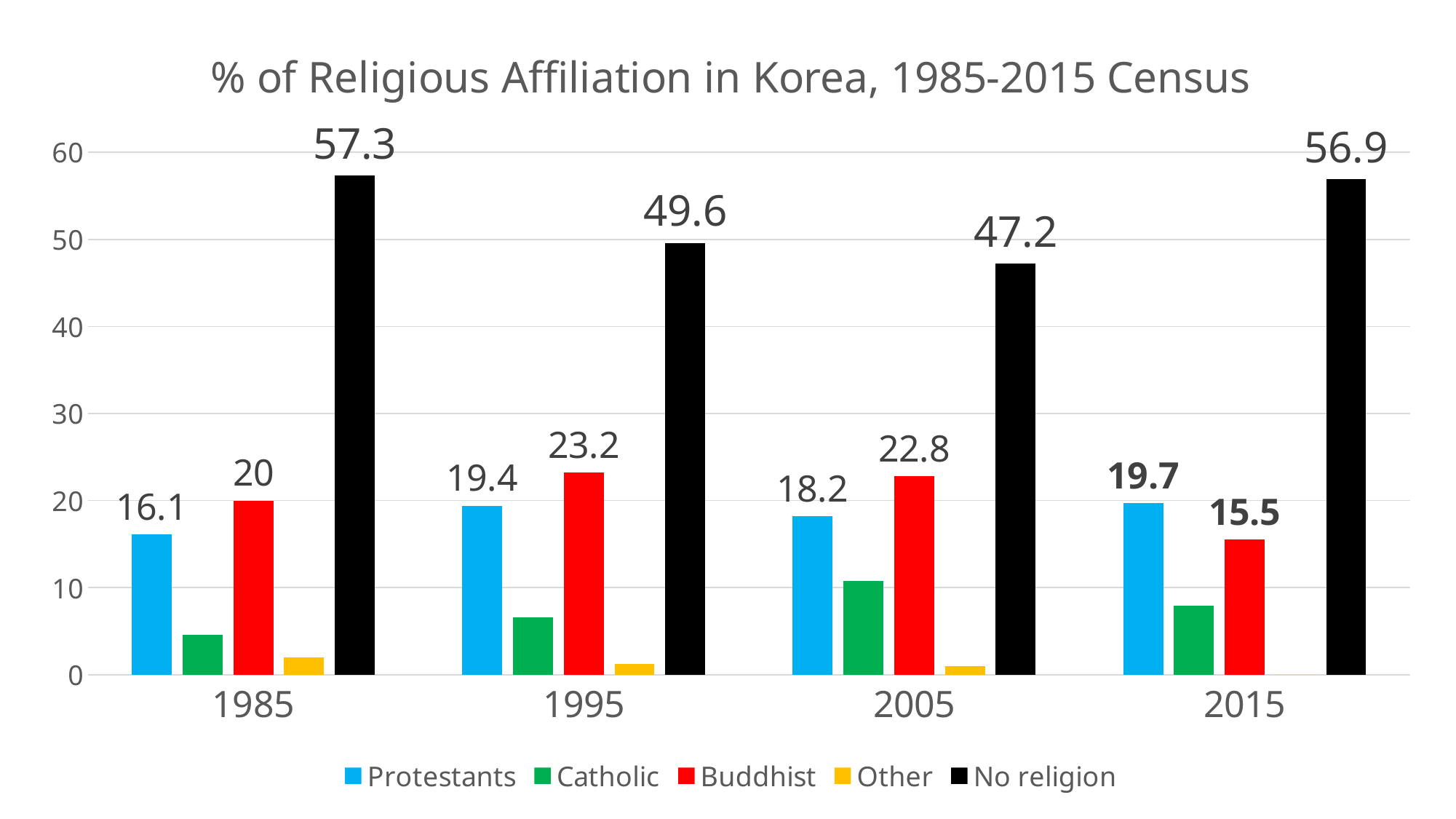
What is the difference between the No religion values in 1985 and 1995? 7.7 Which is larger, the Protestants value in 2015 or the Buddhist value in 2015? Protestants How many years are shown on the x axis? 4 How many series does the legend list? 5 What is the value for Protestants in 2015? 19.7 What is the title of the chart? % of Religious Affiliation in Korea, 1985-2015 Census What is the value for Buddhist in 1995? 23.2 Is the value for Catholic in 2005 greater or less than 20? less In which year is the Buddhist value highest? 1995 What is the value for No religion in 1985? 57.3 In which year is the No religion value lowest? 2005 What kind of chart is shown? bar chart